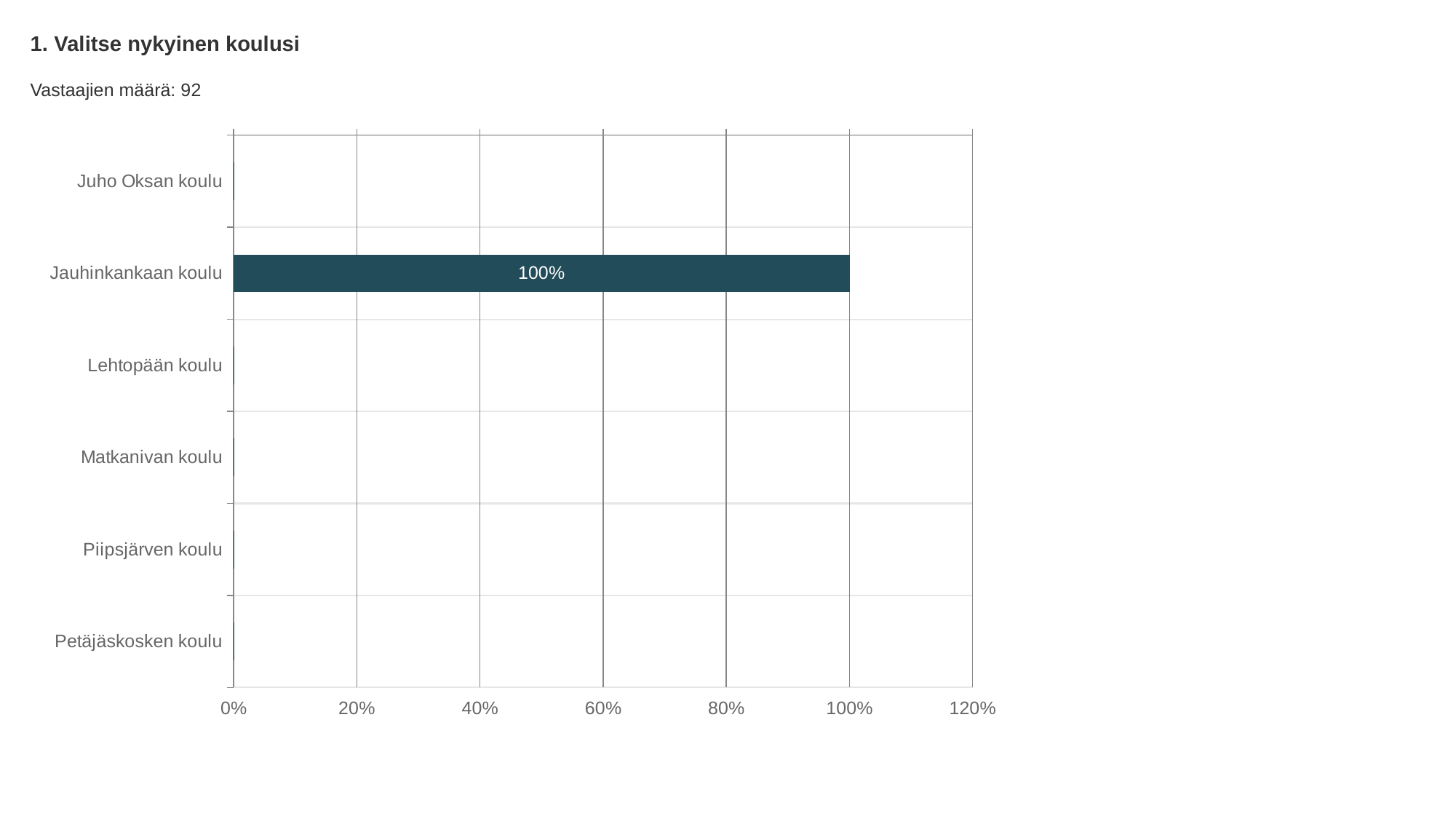
How many school categories are listed on the y axis? 6 What is the highest tick value shown on the x axis? 120% What kind of chart is shown? bar chart Which is larger, the value for Jauhinkankaan koulu or the value for Lehtopään koulu? Jauhinkankaan koulu What is the title of the chart? 1. Valitse nykyinen koulusi What is the number of respondents (Vastaajien määrä) shown on the slide? 92 What is the value for Jauhinkankaan koulu? 100% Which school has the highest value? Jauhinkankaan koulu Is the value for Jauhinkankaan koulu greater or less than 80%? greater How many schools have a visible bar in the chart? 1